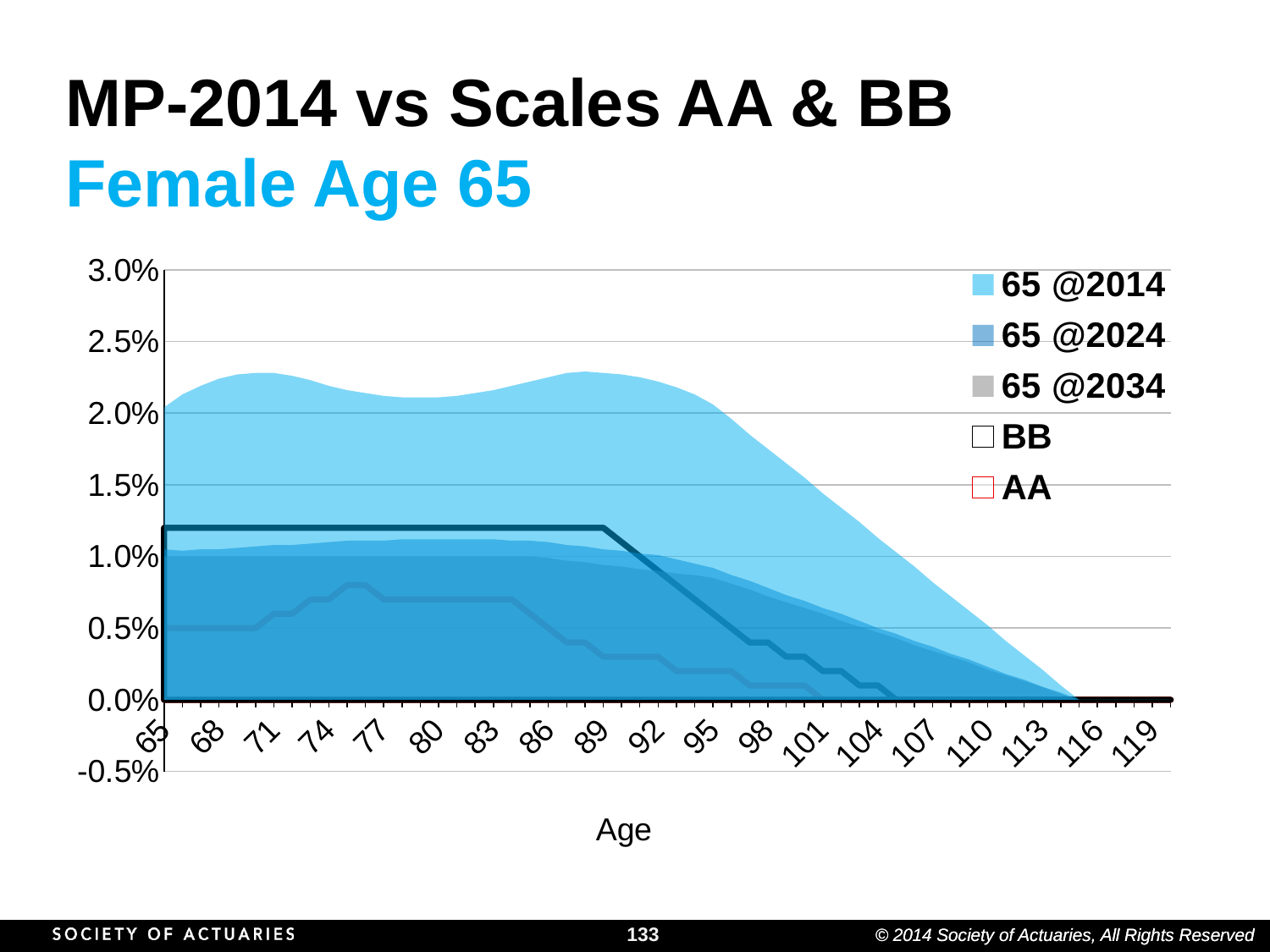
What is the label of the x axis? Age Does the 65 @2014 series rise or fall between age 95 and age 116? Fall How many age labels are shown along the x axis? 19 How many series does the chart legend list? 5 Is the value of the BB series at age 80 greater or less than 1.0%? greater At age 80, which series has the larger value: 65 @2014 or BB? 65 @2014 At age 101, which series has the larger value: 65 @2024 or BB? 65 @2024 What is the title of the slide containing the chart? MP-2014 vs Scales AA & BB Female Age 65 What type of chart is shown on the slide? Area chart Is the value of the 65 @2014 series at age 71 greater or less than 2.0%? greater Is the value of the AA series at age 95 greater or less than 0.5%? less